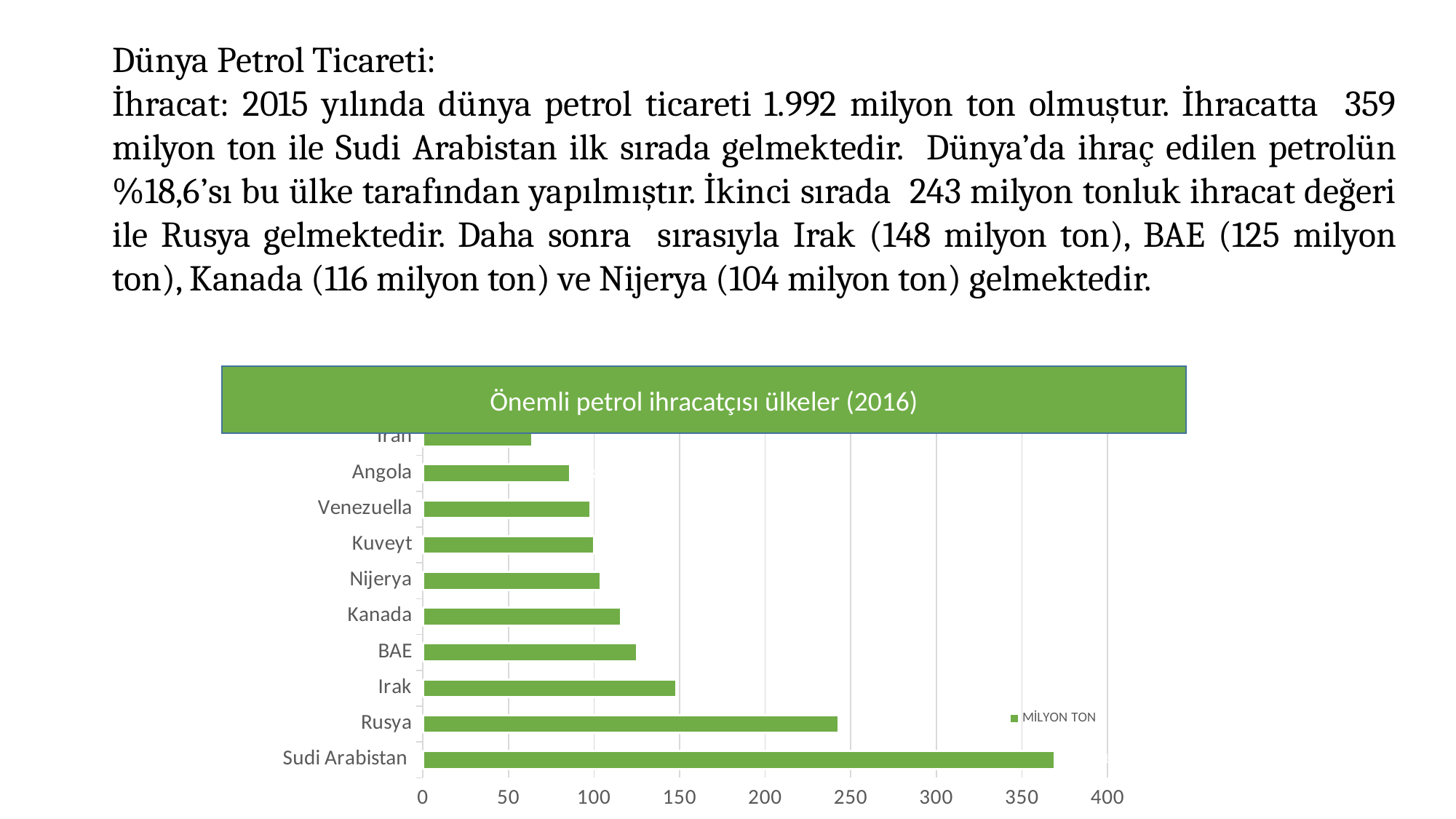
What series does the chart legend list? MİLYON TON How many series does the legend list? 1 Which country has the lowest value in the chart? İran Which country has the highest value in the chart? Sudi Arabistan How many countries are shown in the chart? 10 Which has a larger value, Rusya or Irak? Rusya Which has a larger value, BAE or Kanada? BAE Is the value for Rusya greater or less than 200? greater What kind of chart is shown on the slide? bar chart What is the title of the chart? Önemli petrol ihracatçısı ülkeler (2016) Is the value for Angola greater or less than 100? less Is the value for Sudi Arabistan greater or less than 350? greater